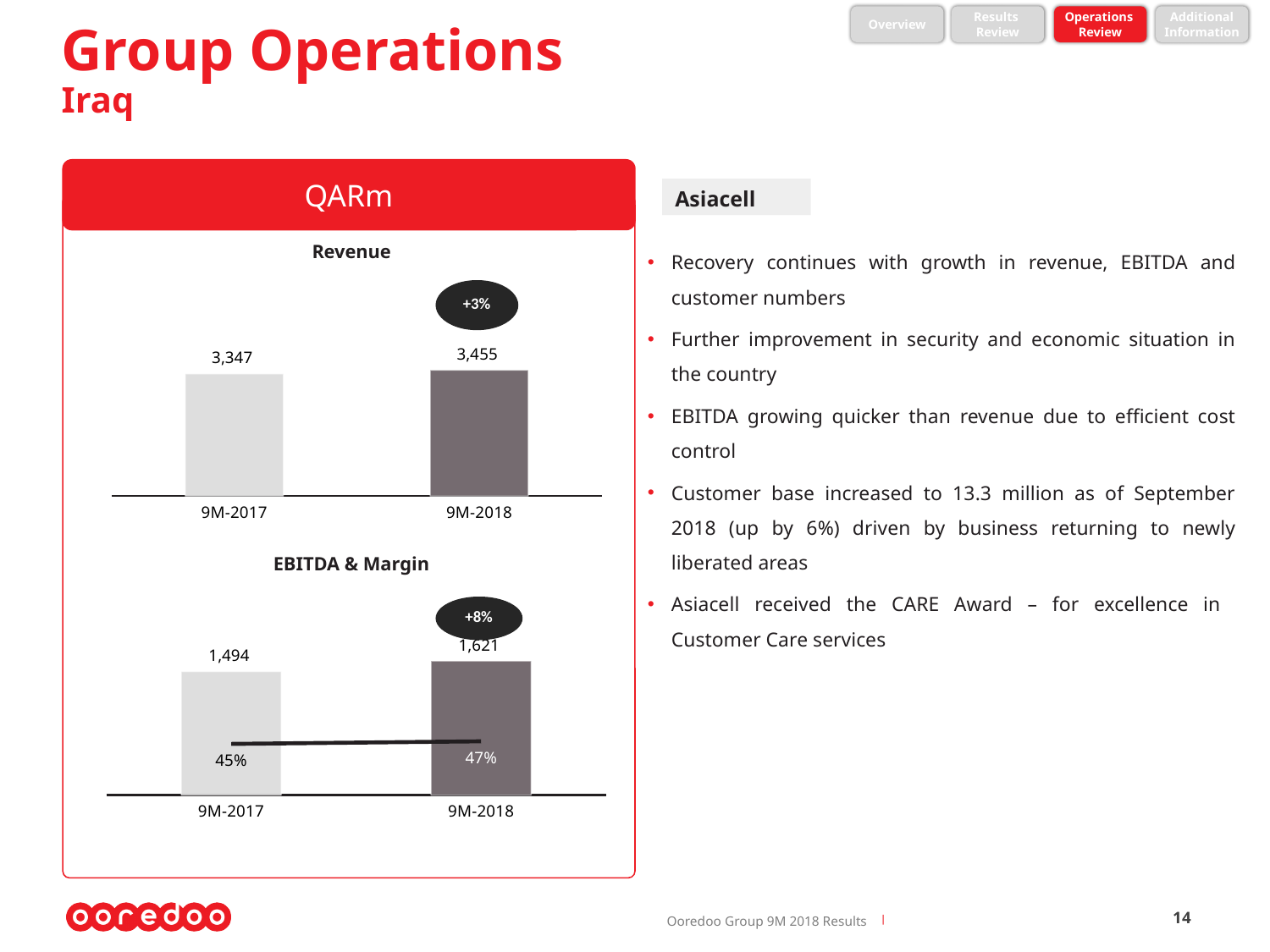
How many periods are shown on the x axis of the Revenue chart? 2 In the EBITDA & Margin chart, what is the difference in EBITDA between 9M-2018 and 9M-2017? 127 In the EBITDA & Margin chart, what is the margin for 9M-2018? 47% In the Revenue chart, what is the difference between the 9M-2018 and 9M-2017 values? 108 In the EBITDA & Margin chart, what is the EBITDA value for 9M-2018? 1,621 In the Revenue chart, what is the value for 9M-2018? 3,455 In the Revenue chart, what percentage change is shown in the bubble above the 9M-2018 bar? +3% In the EBITDA & Margin chart, which period has the higher EBITDA, 9M-2017 or 9M-2018? 9M-2018 In the EBITDA & Margin chart, what is the EBITDA value for 9M-2017? 1,494 What unit is shown in the red header above the charts? QARm In the Revenue chart, what is the value for 9M-2017? 3,347 In the EBITDA & Margin chart, what is the margin for 9M-2017? 45%